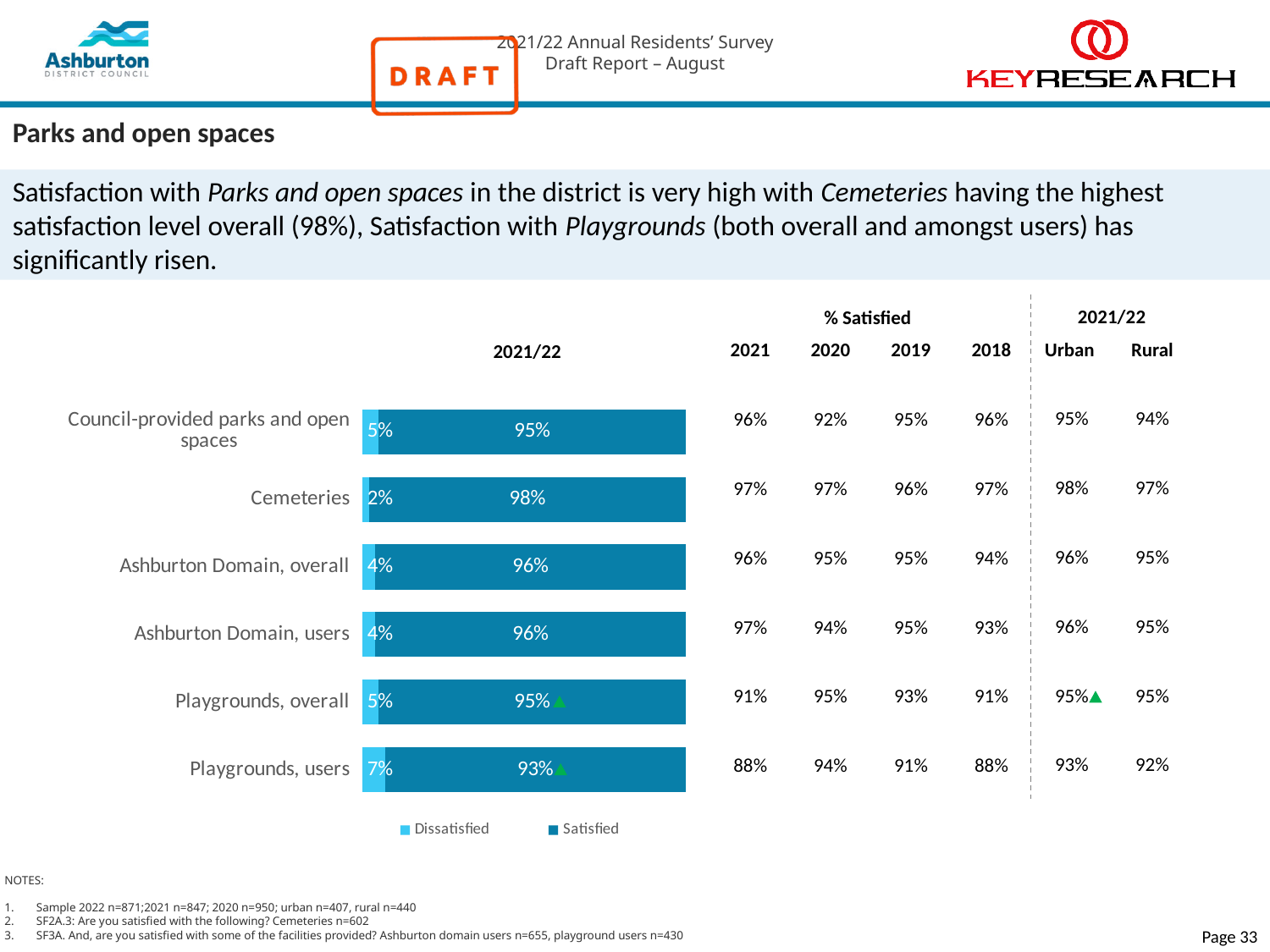
How many categories are shown in the 2021/22 bar chart? 6 What percentage of respondents were satisfied with Cemeteries in 2021/22? 98% What type of chart is used to show the 2021/22 satisfaction results? Stacked bar chart What are the two series named in the chart legend? Dissatisfied and Satisfied What is the total of the Dissatisfied and Satisfied segments for Ashburton Domain, overall in 2021/22? 100% Which category has the highest satisfied percentage in the 2021/22 chart? Cemeteries What percentage of respondents were dissatisfied with Playgrounds, users in 2021/22? 7% Which has a higher dissatisfied percentage in 2021/22: Cemeteries or Playgrounds, overall? Playgrounds, overall Which category has the lowest satisfied percentage in the 2021/22 chart? Playgrounds, users What is the satisfied percentage for Council-provided parks and open spaces in 2021/22? 95% What is the difference between the satisfied percentage for Cemeteries and for Playgrounds, users in 2021/22? 5% How many series does the chart legend list? 2